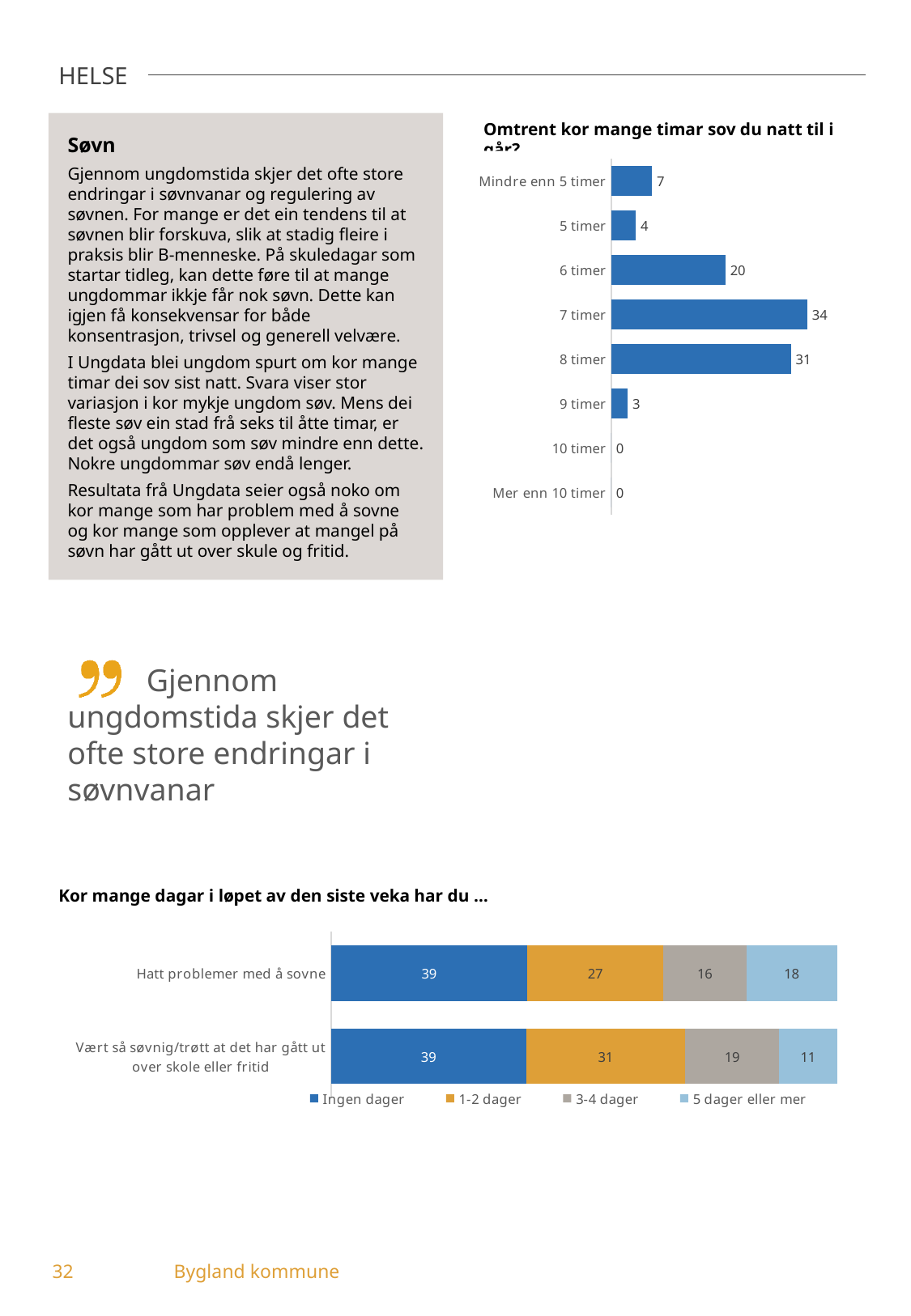
How many categories are shown in the top chart on the slide? 8 In the top chart on the slide, what is the difference between the values for "7 timer" and "8 timer"? 3 In the bottom chart titled "Kor mange dagar i løpet av den siste veka har du ...", what is the value for "5 dager eller mer" in the "Vært så søvnig/trøtt at det har gått ut over skole eller fritid" bar? 11 In the top chart on the slide, which is larger: the value for "Mindre enn 5 timer" or the value for "5 timer"? Mindre enn 5 timer In the bottom chart titled "Kor mange dagar i løpet av den siste veka har du ...", what is the difference between the "3-4 dager" values of the two bars? 3 In the bottom chart titled "Kor mange dagar i løpet av den siste veka har du ...", what is the value for "1-2 dager" in the "Hatt problemer med å sovne" bar? 27 In the bottom chart titled "Kor mange dagar i løpet av den siste veka har du ...", what is the total of the "Hatt problemer med å sovne" bar? 100 How many series does the legend list in the bottom chart titled "Kor mange dagar i løpet av den siste veka har du ..."? 4 In the top chart on the slide, what is the value for "7 timer"? 34 In the top chart on the slide, what is the value for "6 timer"? 20 In the top chart on the slide, which category has the highest value? 7 timer What kind of chart is the top chart on the slide? Bar chart